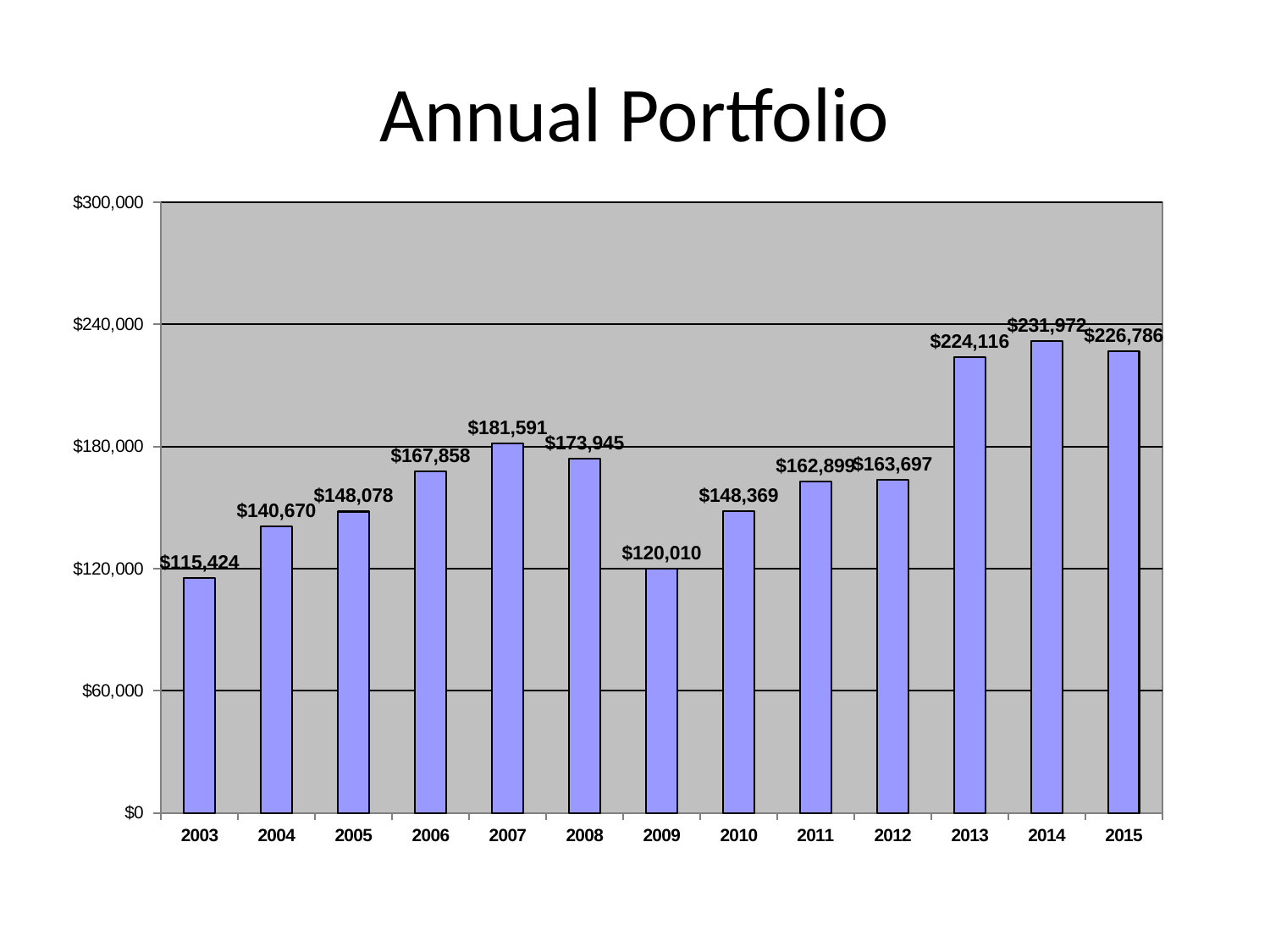
Which year has the lowest value? 2003 What is the value for 2009? $120,010 What is the difference between the values for 2014 and 2013? $7,856 What is the value for 2013? $224,116 What kind of chart is this? bar chart Which year has the highest value? 2014 What is the value for 2007? $181,591 How many years are shown on the x axis? 13 What is the difference between the values for 2009 and 2003? $4,586 Is the value for 2006 greater or less than $180,000? less Which is larger, the value for 2008 or the value for 2007? 2007 Do the values rise or fall from 2003 to 2007? rise